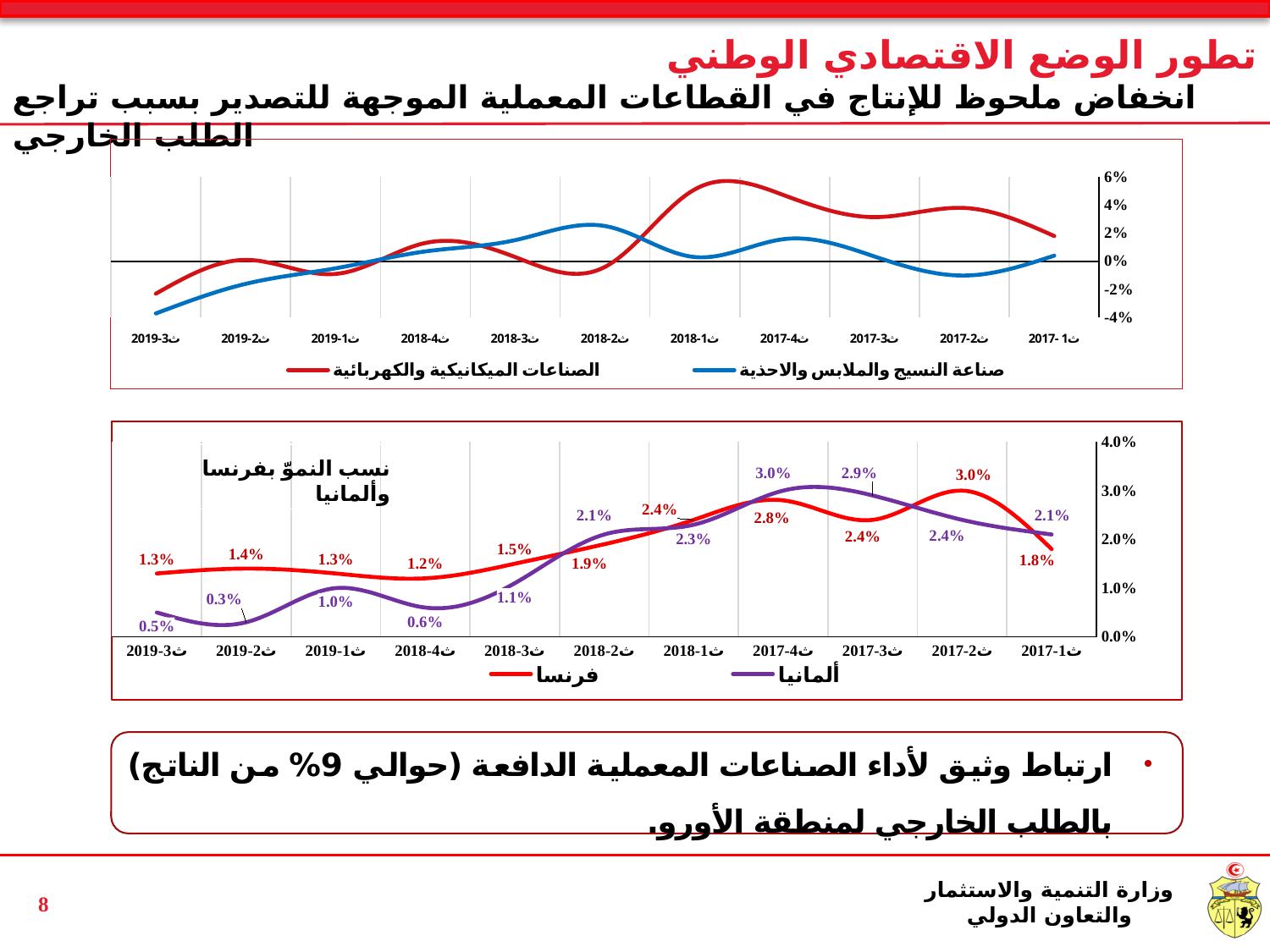
In the bottom chart (نسب النموّ بفرنسا وألمانيا), what is the growth rate for فرنسا in ث2-2017? 3.0% In the bottom chart (نسب النموّ بفرنسا وألمانيا), how many quarters are shown on the x axis? 11 In the bottom chart (نسب النموّ بفرنسا وألمانيا), in which quarter does ألمانيا have its lowest growth rate? ث2-2019 In the top chart, is the value for صناعة النسيج والملابس والاحذية in ث3-2019 greater or less than -2%? less In the bottom chart (نسب النموّ بفرنسا وألمانيا), what is the growth rate for ألمانيا in ث4-2017? 3.0% What type of chart is the top chart? Line chart In the bottom chart (نسب النموّ بفرنسا وألمانيا), in which quarter does فرنسا have its lowest growth rate? ث4-2018 In the bottom chart (نسب النموّ بفرنسا وألمانيا), what is the growth rate for ألمانيا in ث2-2019? 0.3% In the bottom chart (نسب النموّ بفرنسا وألمانيا), which country has the higher growth rate in ث3-2017? ألمانيا In the top chart, is the value for الصناعات الميكانيكية والكهربائية in ث1-2018 greater or less than 4%? greater In the bottom chart (نسب النموّ بفرنسا وألمانيا), what is the difference between the فرنسا and ألمانيا values in ث3-2019? 0.8 percentage points In the top chart, how many series does the legend list? 2